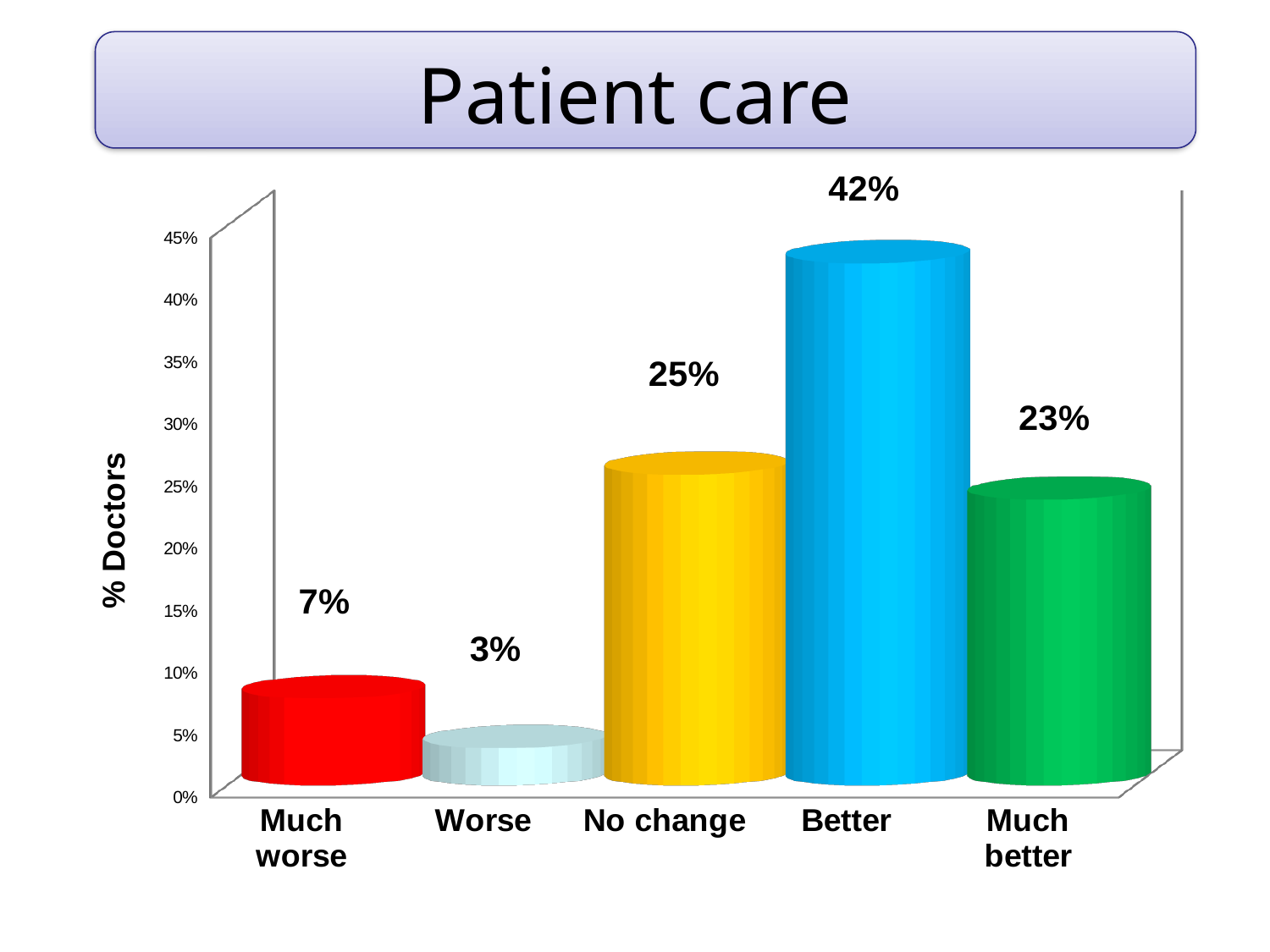
What is the label on the vertical axis? % Doctors What percentage of doctors reported 'No change' in patient care? 25% Which is larger, the value for 'No change' or the value for 'Much better'? No change What is the difference between the 'Better' and 'Much better' values? 19% Which category has the lowest percentage of doctors? Worse What is the title of the slide? Patient care What percentage of doctors said patient care was 'Better'? 42% How many categories are shown on the x axis? 5 Is the value for 'Much worse' greater or less than 10%? less Which category has the highest percentage of doctors? Better What is the value for 'Much worse'? 7% What kind of chart is shown on the slide? bar chart